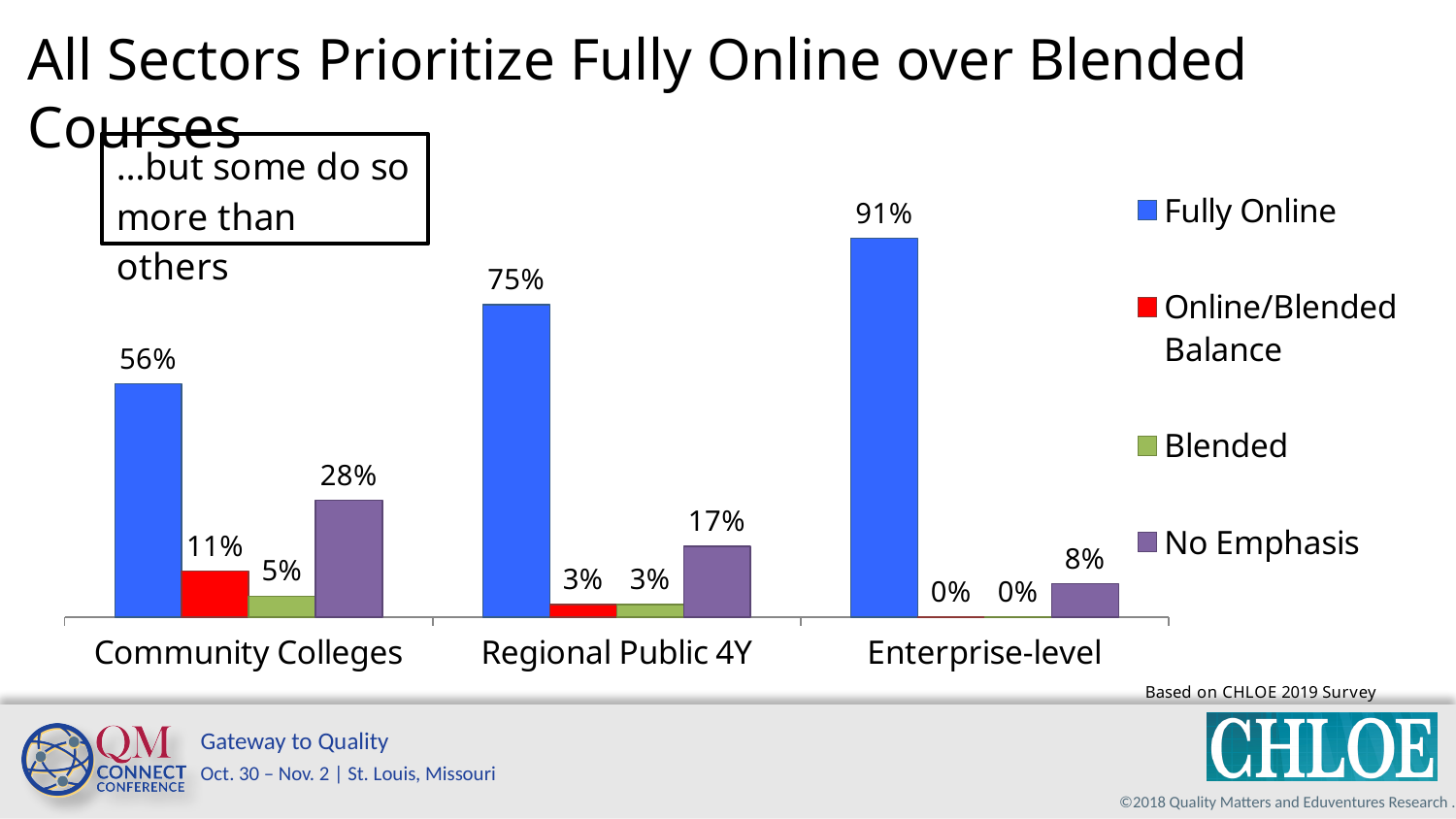
Do the Fully Online values rise or fall from Community Colleges to Enterprise-level? Rise What is the Online/Blended Balance value for Enterprise-level? 0% Which is larger for Community Colleges: Online/Blended Balance or Blended? Online/Blended Balance What is the difference between the Fully Online values for Enterprise-level and Community Colleges? 35% How many series does the legend list? 4 How many categories are shown on the x axis? 3 Which legend entry is shown in red? Online/Blended Balance Which category has the lowest No Emphasis value? Enterprise-level Which category has the highest Fully Online value? Enterprise-level What is the Fully Online value for Community Colleges? 56% What is the No Emphasis value for Regional Public 4Y? 17% What kind of chart is shown on the slide? Bar chart